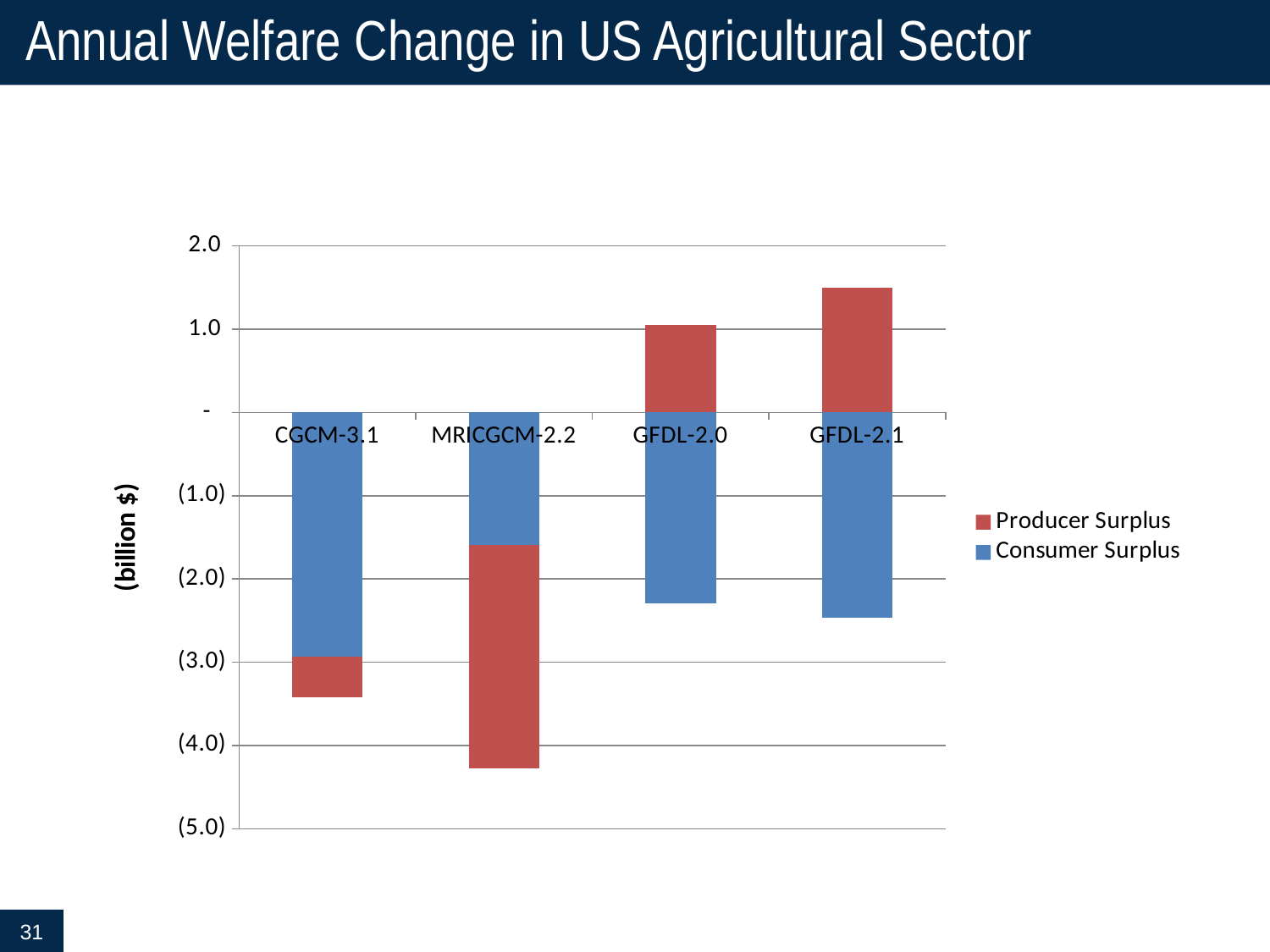
What is the label on the vertical axis? (billion $) Is the Producer Surplus for GFDL-2.1 greater or less than 1.0? greater Which has the larger Producer Surplus, GFDL-2.0 or GFDL-2.1? GFDL-2.1 Is the total welfare change for MRICGCM-2.2 greater or less than (4.0)? less How many categories (climate models) are shown on the x axis? 4 Is the Consumer Surplus for CGCM-3.1 greater or less than (2.0)? less Which category has the most negative Consumer Surplus? CGCM-3.1 Which category has the lowest (most negative) total welfare change? MRICGCM-2.2 What kind of chart is shown on the slide? Stacked bar chart Which colour represents Producer Surplus in the chart? Red How many series does the legend list? 2 Which category has the largest positive Producer Surplus? GFDL-2.1